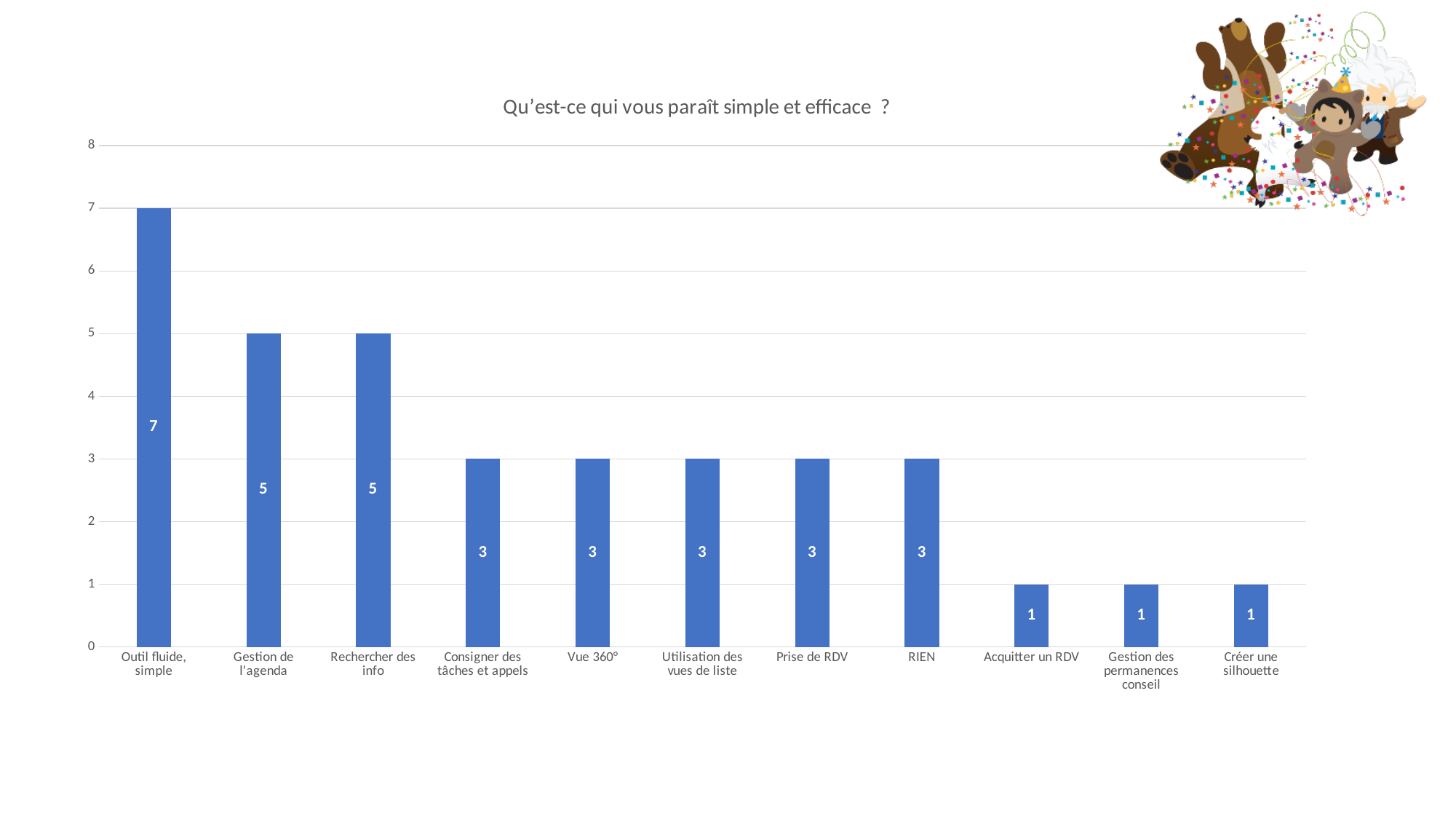
What is the value for "Outil fluide, simple"? 7 How many categories are shown on the x axis? 11 What is the difference between the values for "Outil fluide, simple" and "Rechercher des info"? 2 Which is larger, the value for "Gestion de l'agenda" or the value for "RIEN"? Gestion de l'agenda What is the value for "Gestion des permanences conseil"? 1 What kind of chart is shown on the slide? bar chart What is the difference between the values for "Prise de RDV" and "Acquitter un RDV"? 2 Which category has the highest value? Outil fluide, simple Is the value for "Outil fluide, simple" greater or less than 6? greater What is the value for "Vue 360°"? 3 What is the title of the chart? Qu'est-ce qui vous paraît simple et efficace ? What is the value for "Gestion de l'agenda"? 5